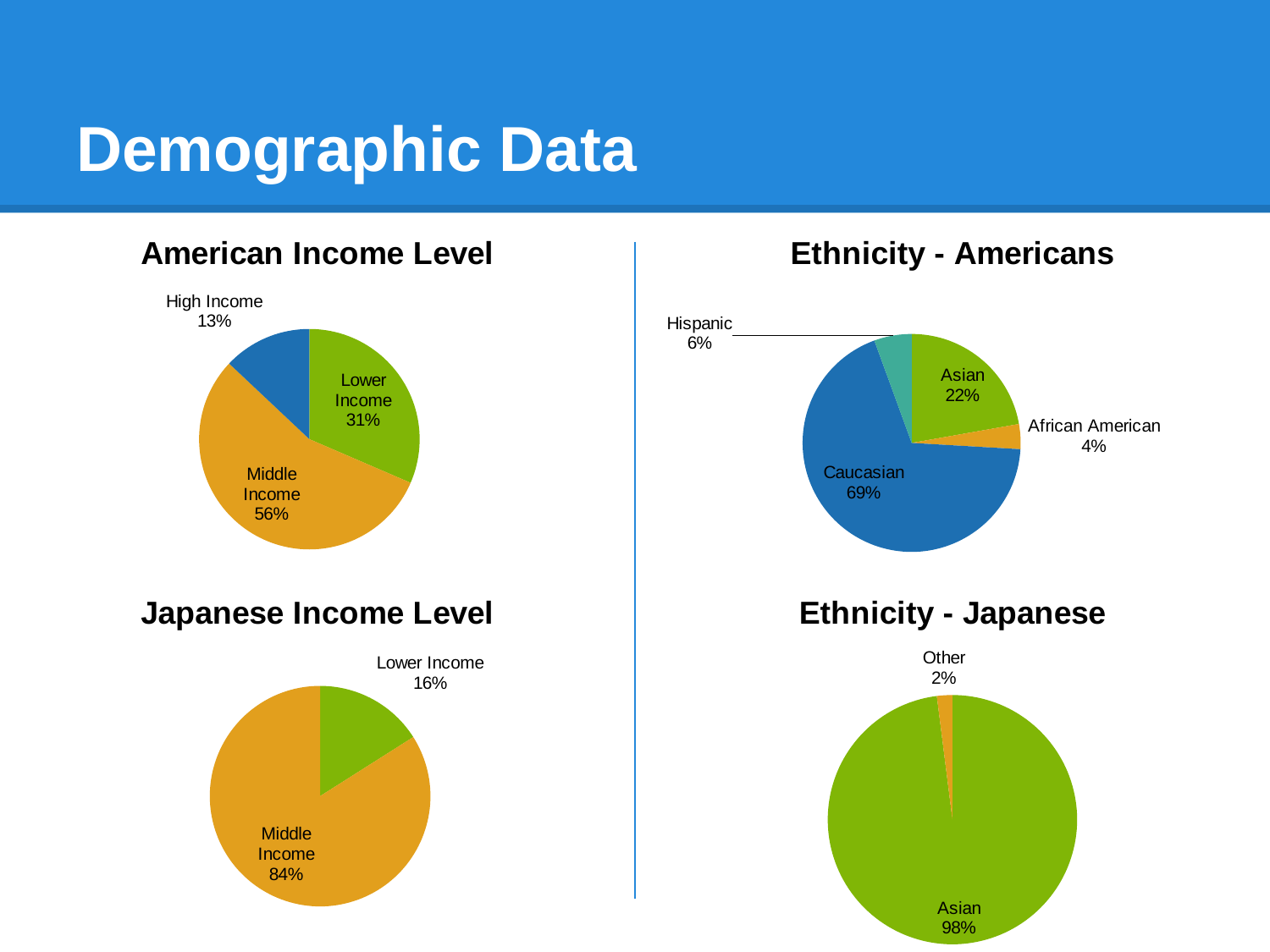
In the Ethnicity - Japanese chart, what share is Asian? 98% In the American Income Level chart, what is the difference between the Middle Income and Lower Income shares? 25% In the American Income Level chart, what share is Middle Income? 56% In the Ethnicity - Americans chart, which ethnicity has the smallest share? African American How many charts are shown on the slide? 4 In the Japanese Income Level chart, what share is Lower Income? 16% How many slices does the Ethnicity - Americans chart have? 4 How many slices does the Japanese Income Level chart have? 2 What kind of chart is the Ethnicity - Japanese chart? Pie chart In the Ethnicity - Americans chart, which is larger, Asian or Hispanic? Asian In the Ethnicity - Americans chart, what share is Caucasian? 69% In the American Income Level chart, which income level has the smallest share? High Income